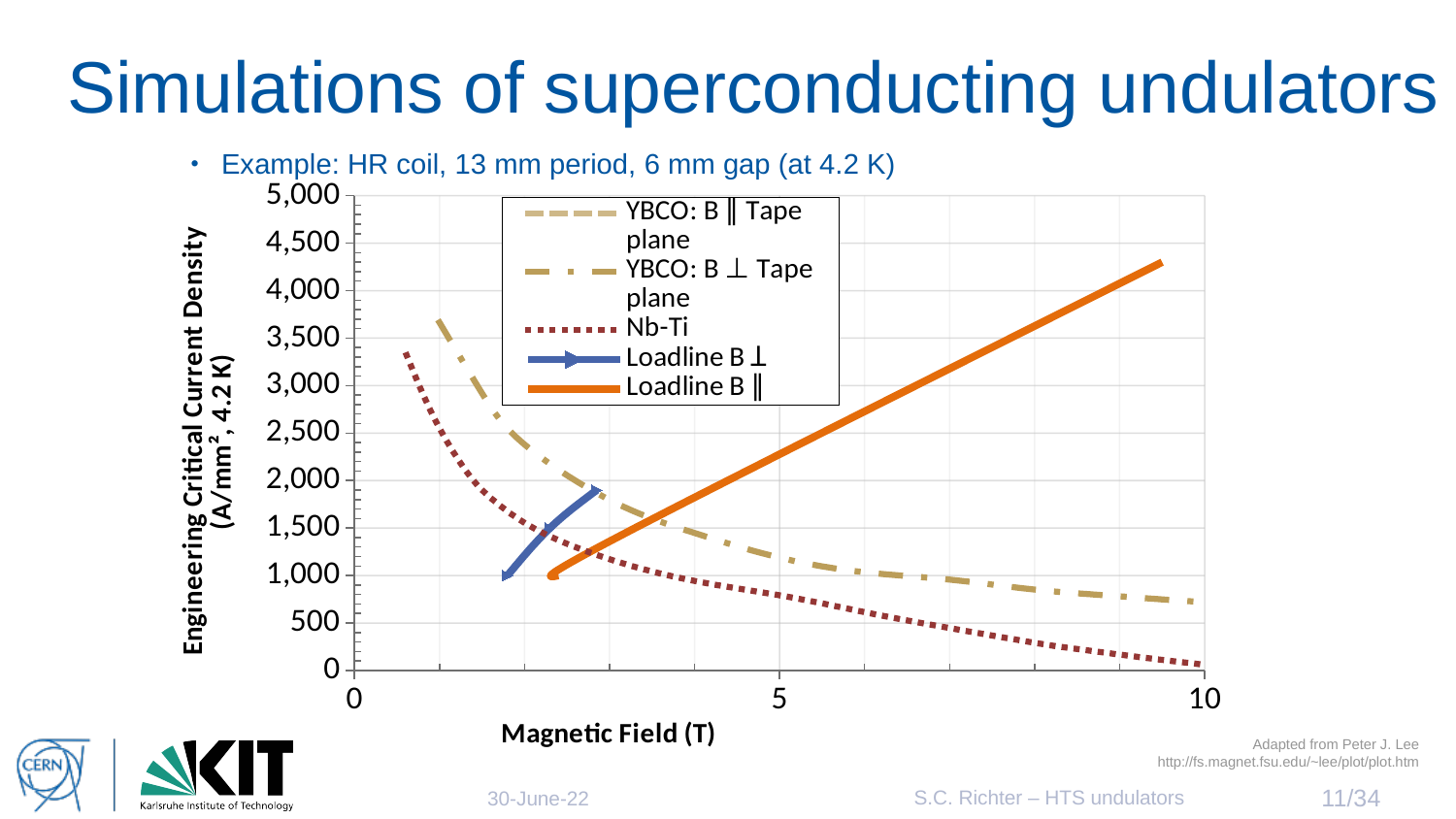
Is the value of the Nb-Ti curve at 1 T greater or less than 2,000? greater What kind of chart is shown on the slide? line chart Does the YBCO: B ⊥ Tape plane curve rise or fall as the magnetic field increases? fall What is the title of the x axis? Magnetic Field (T) Does the Loadline B ∥ line rise or fall as the magnetic field increases? rise How many series does the legend list? 5 Does the Nb-Ti curve rise or fall as the magnetic field increases? fall Is the value of the Nb-Ti curve at 8 T greater or less than 500? less What is the title of the y axis? Engineering Critical Current Density (A/mm², 4.2 K) Is the value of the YBCO: B ⊥ Tape plane curve at 5 T greater or less than 1,000? greater